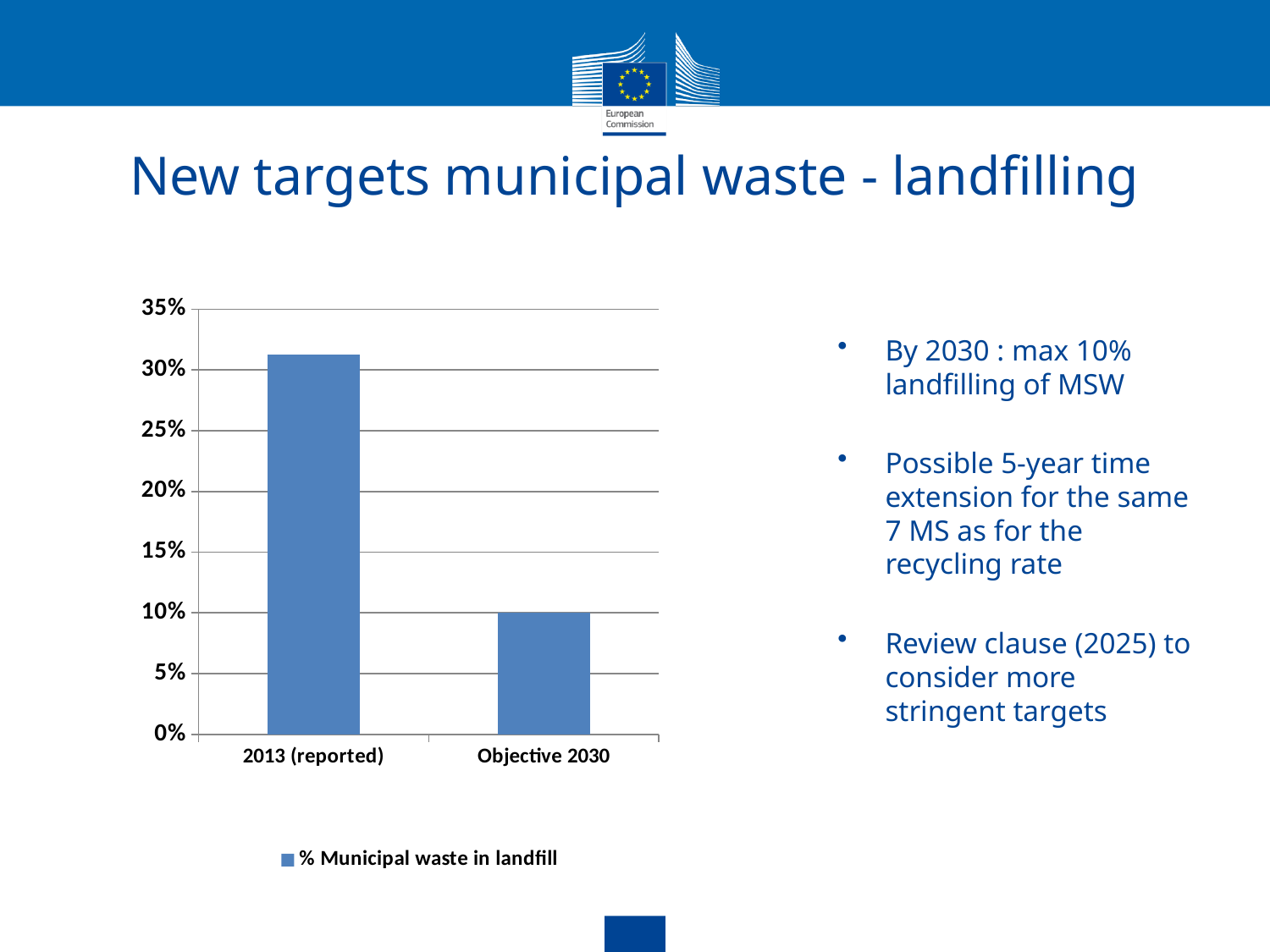
What is the value for Objective 2030 in the chart? 10% Is the value for 2013 (reported) greater or less than 35%? less What series name is shown in the chart legend? % Municipal waste in landfill Do the values rise or fall from 2013 (reported) to Objective 2030? fall What is the highest value shown on the chart's vertical axis? 35% Is the value for 2013 (reported) greater or less than 30%? greater Which is larger, the value for 2013 (reported) or the value for Objective 2030? 2013 (reported) Which category has the highest value in the chart? 2013 (reported) How many series does the chart legend list? 1 Which category has the lowest value in the chart? Objective 2030 What kind of chart is shown on the slide? bar chart How many categories are plotted on the x axis of the chart? 2